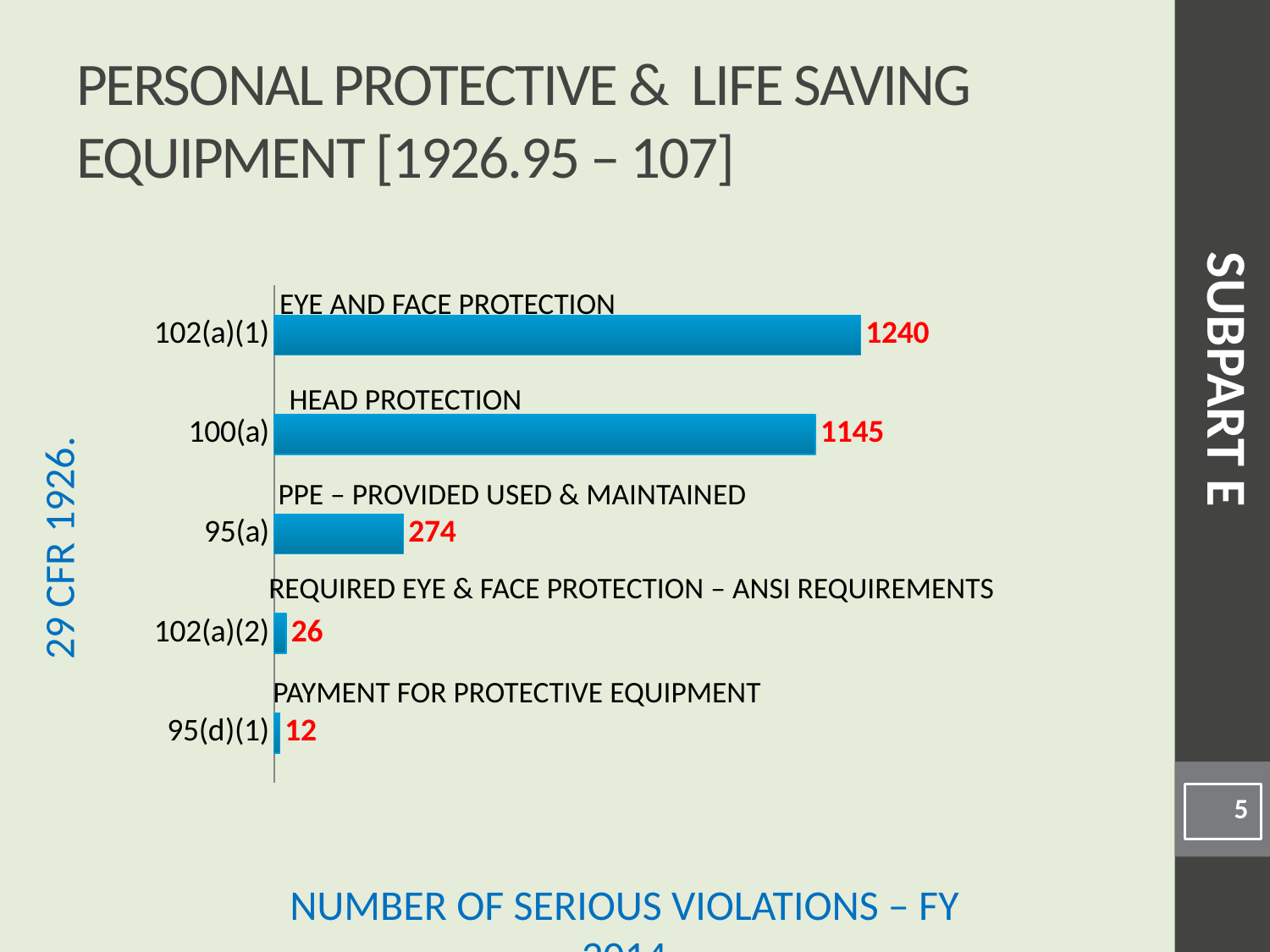
Which category has the lowest number of serious violations? 95(d)(1) What kind of chart is shown on the slide? Bar chart What is the difference in serious violations between 102(a)(1) and 100(a)? 95 How many categories are shown in the chart? 5 What is the number of serious violations for 95(d)(1) (Payment for Protective Equipment)? 12 What is the number of serious violations for 95(a) (PPE – Provided Used & Maintained)? 274 What is the number of serious violations for 102(a)(1) (Eye and Face Protection)? 1240 Which has more serious violations, 95(a) or 102(a)(2)? 95(a) Which category has the highest number of serious violations? 102(a)(1) What is the difference in serious violations between 95(a) and 102(a)(2)? 248 What is the number of serious violations for 100(a) (Head Protection)? 1145